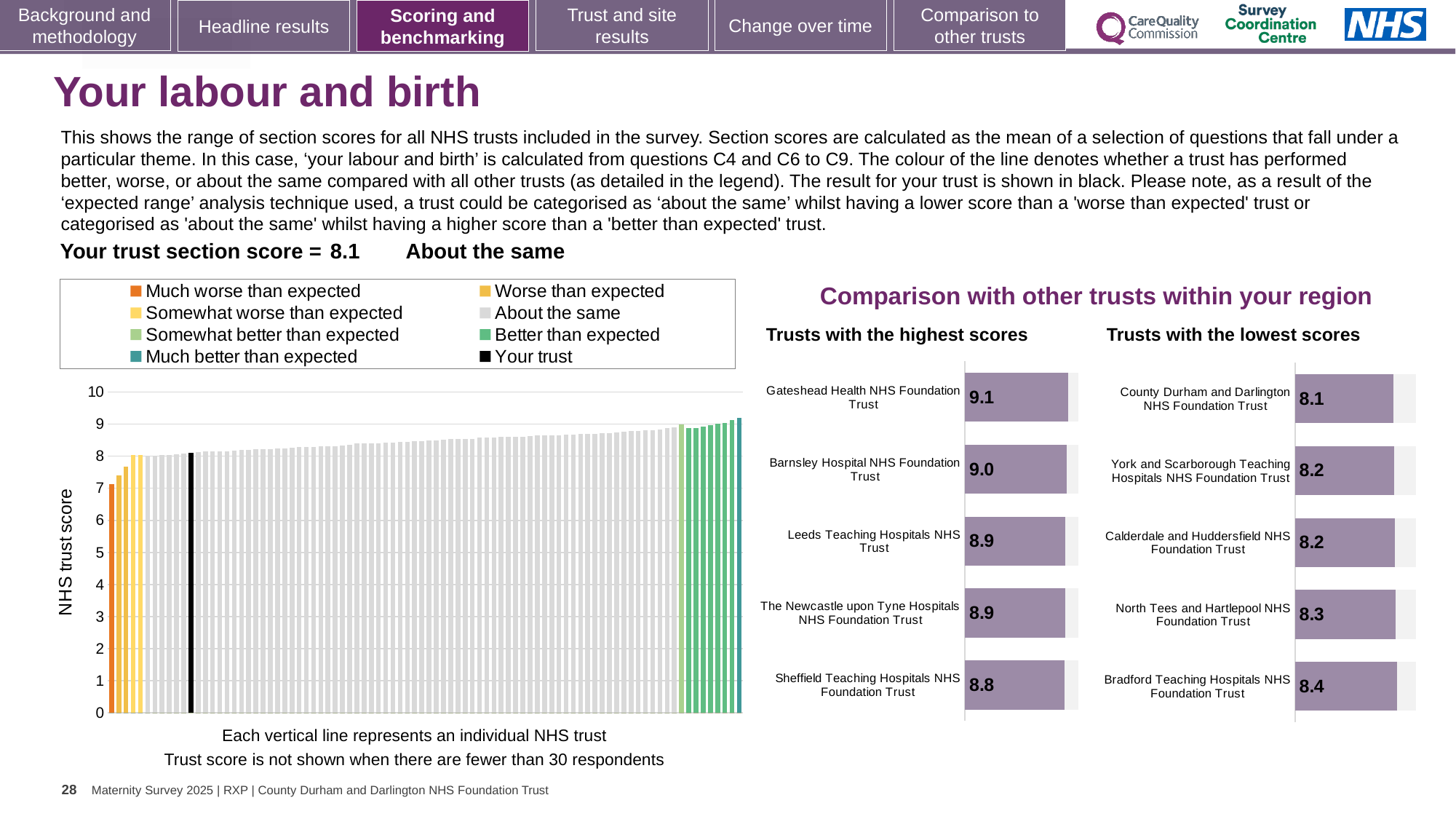
In the 'NHS trust score' chart on the left, what is the section score for your trust (the black bar)? 8.1 In the 'Trusts with the highest scores' chart, which has the larger score: Barnsley Hospital NHS Foundation Trust or Leeds Teaching Hospitals NHS Trust? Barnsley Hospital NHS Foundation Trust In the 'Trusts with the highest scores' chart, what is the score for Gateshead Health NHS Foundation Trust? 9.1 How many trusts are shown in the 'Trusts with the lowest scores' chart? 5 In the 'NHS trust score' chart on the left, do the bar values rise or fall from left to right? Rise In the 'Trusts with the highest scores' chart, which trust has the highest score? Gateshead Health NHS Foundation Trust In the 'Trusts with the highest scores' chart, what is the score for Sheffield Teaching Hospitals NHS Foundation Trust? 8.8 How many entries does the legend of the 'NHS trust score' chart on the left list? 8 In the 'Trusts with the highest scores' chart, what is the difference between the scores of Gateshead Health NHS Foundation Trust and Sheffield Teaching Hospitals NHS Foundation Trust? 0.3 In the 'Trusts with the lowest scores' chart, what is the score for Bradford Teaching Hospitals NHS Foundation Trust? 8.4 What kind of chart is the 'NHS trust score' chart on the left? Bar chart In the 'Trusts with the lowest scores' chart, which trust has the lowest score? County Durham and Darlington NHS Foundation Trust